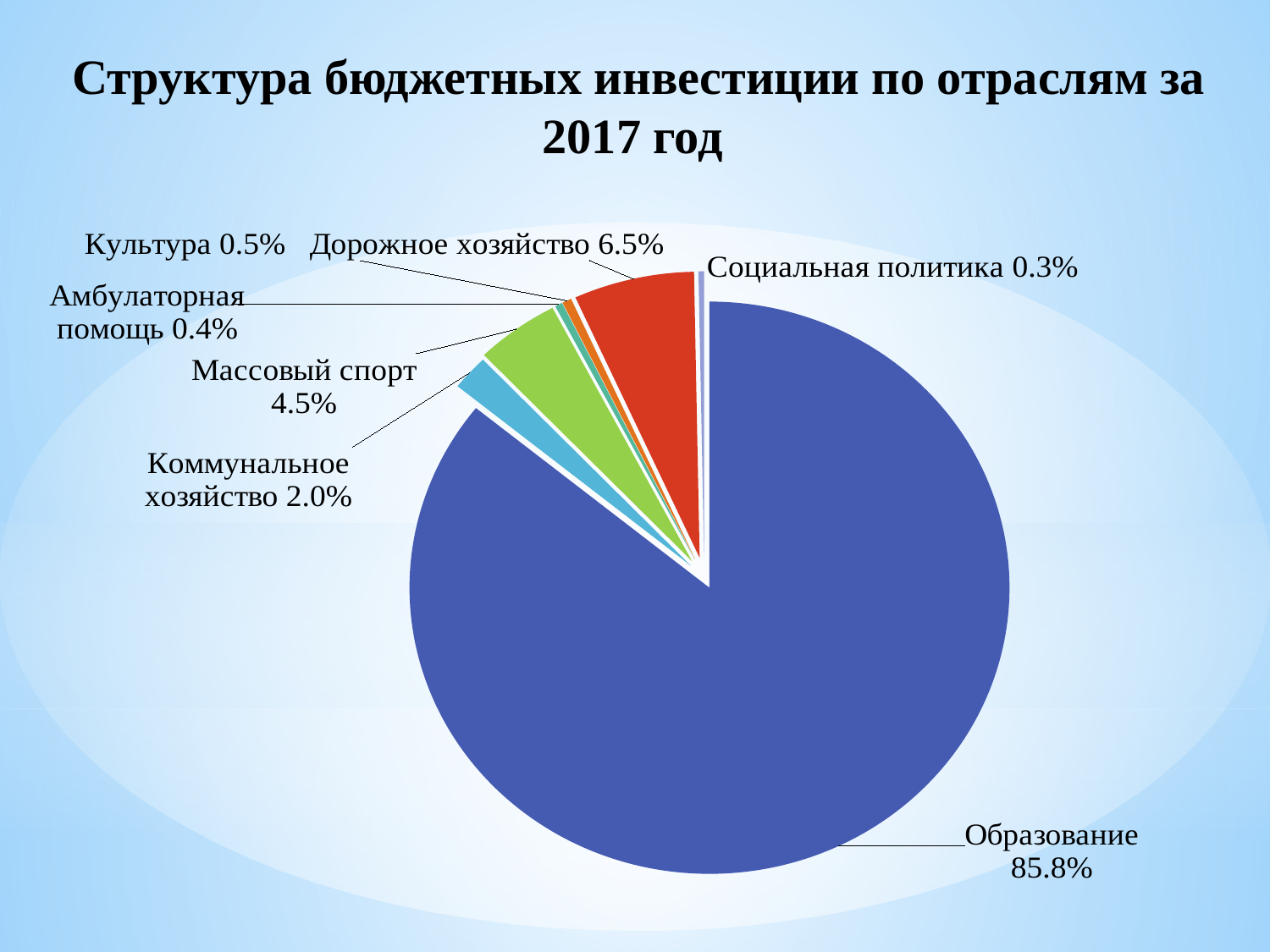
What year does the chart title refer to? 2017 What share of budget investments goes to Массовый спорт? 4.5% What share of budget investments goes to Дорожное хозяйство? 6.5% What kind of chart is shown on the slide? pie chart What share of budget investments goes to Коммунальное хозяйство? 2.0% What is the difference between the shares of Дорожное хозяйство and Массовый спорт? 2.0% Which sector has the smallest share of budget investments? Социальная политика What share of budget investments goes to Образование? 85.8% Which has a larger share: Культура or Амбулаторная помощь? Культура What share of budget investments goes to Социальная политика? 0.3% How many sectors are shown in the pie chart? 7 Which sector has the largest share of budget investments? Образование